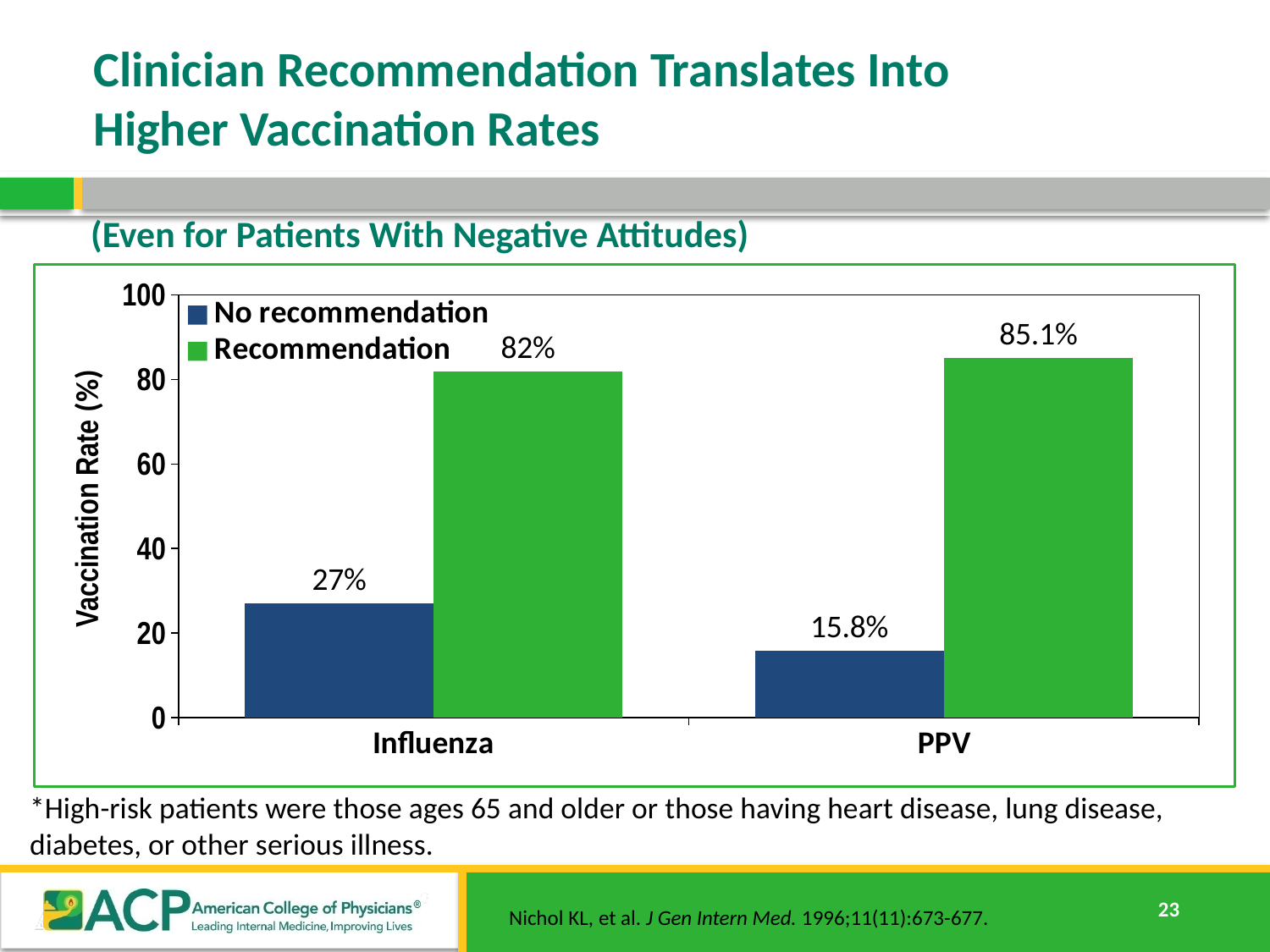
What is the vaccination rate for PPV with no recommendation? 15.8% What kind of chart is shown on the slide? Bar chart Which bar shows the highest vaccination rate? PPV, Recommendation What is the label of the y axis? Vaccination Rate (%) How many vaccine categories are shown on the x axis? 2 What is the vaccination rate for Influenza with no recommendation? 27% What is the vaccination rate for PPV with a recommendation? 85.1% Which bar shows the lowest vaccination rate? PPV, No recommendation What is the vaccination rate for Influenza with a recommendation? 82% What is the difference between the Recommendation and No recommendation vaccination rates for Influenza? 55 percentage points How many series does the legend list? 2 Which is larger: the No recommendation rate for Influenza or the No recommendation rate for PPV? Influenza